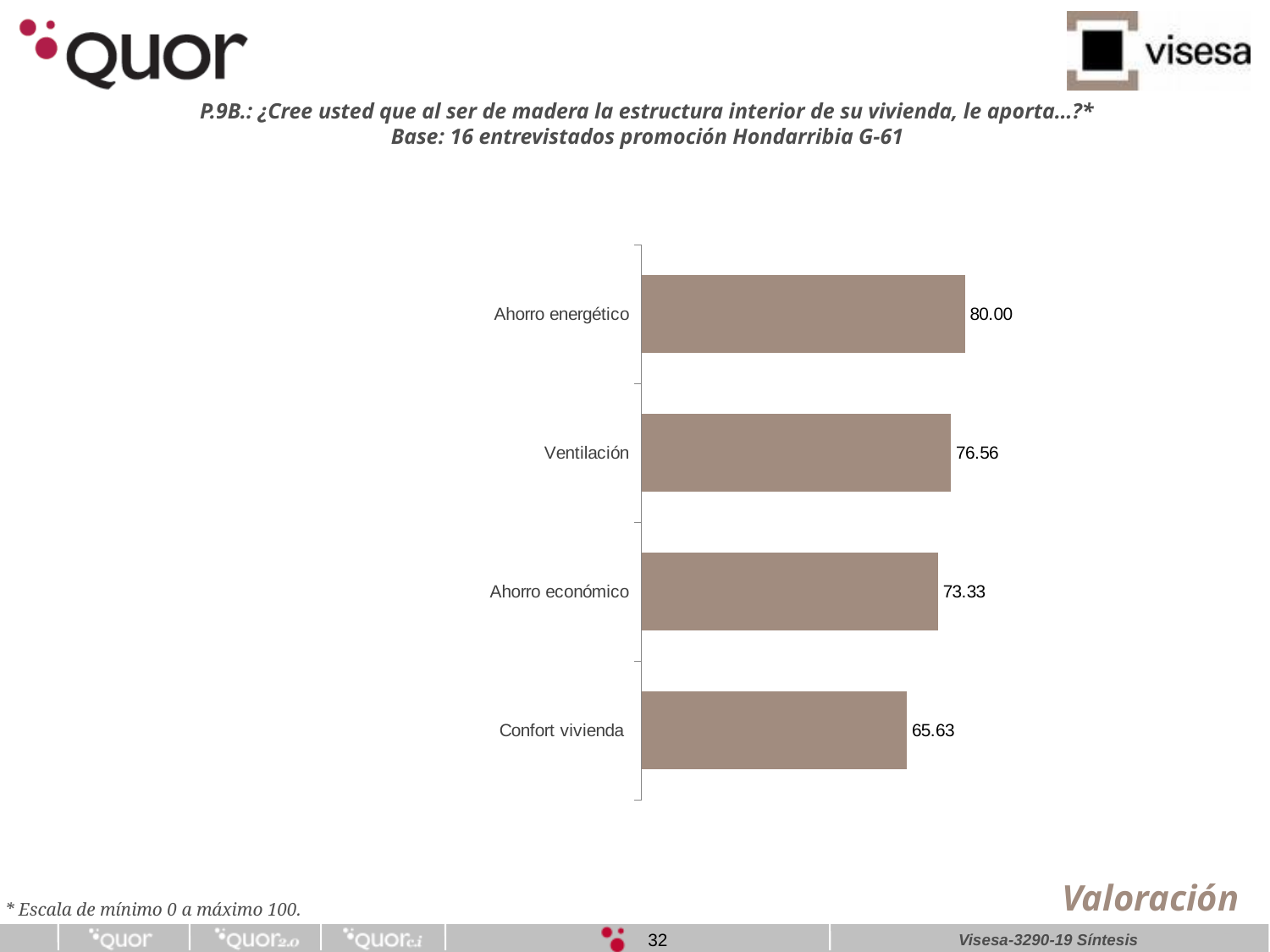
What kind of chart is shown on the slide? Bar chart Which is larger, the value for Ventilación or the value for Ahorro económico? Ventilación What is the difference between the values for Ahorro energético and Confort vivienda? 14.37 What is the value for Ahorro energético? 80.00 How many categories are shown in the chart? 4 What is the value for Ventilación? 76.56 What is the difference between the values for Ventilación and Ahorro económico? 3.23 Which category has the highest value? Ahorro energético What is the value for Ahorro económico? 73.33 What is the value for Confort vivienda? 65.63 Which category has the lowest value? Confort vivienda According to the footnote, what is the scale used for the values in the chart? Mínimo 0 a máximo 100